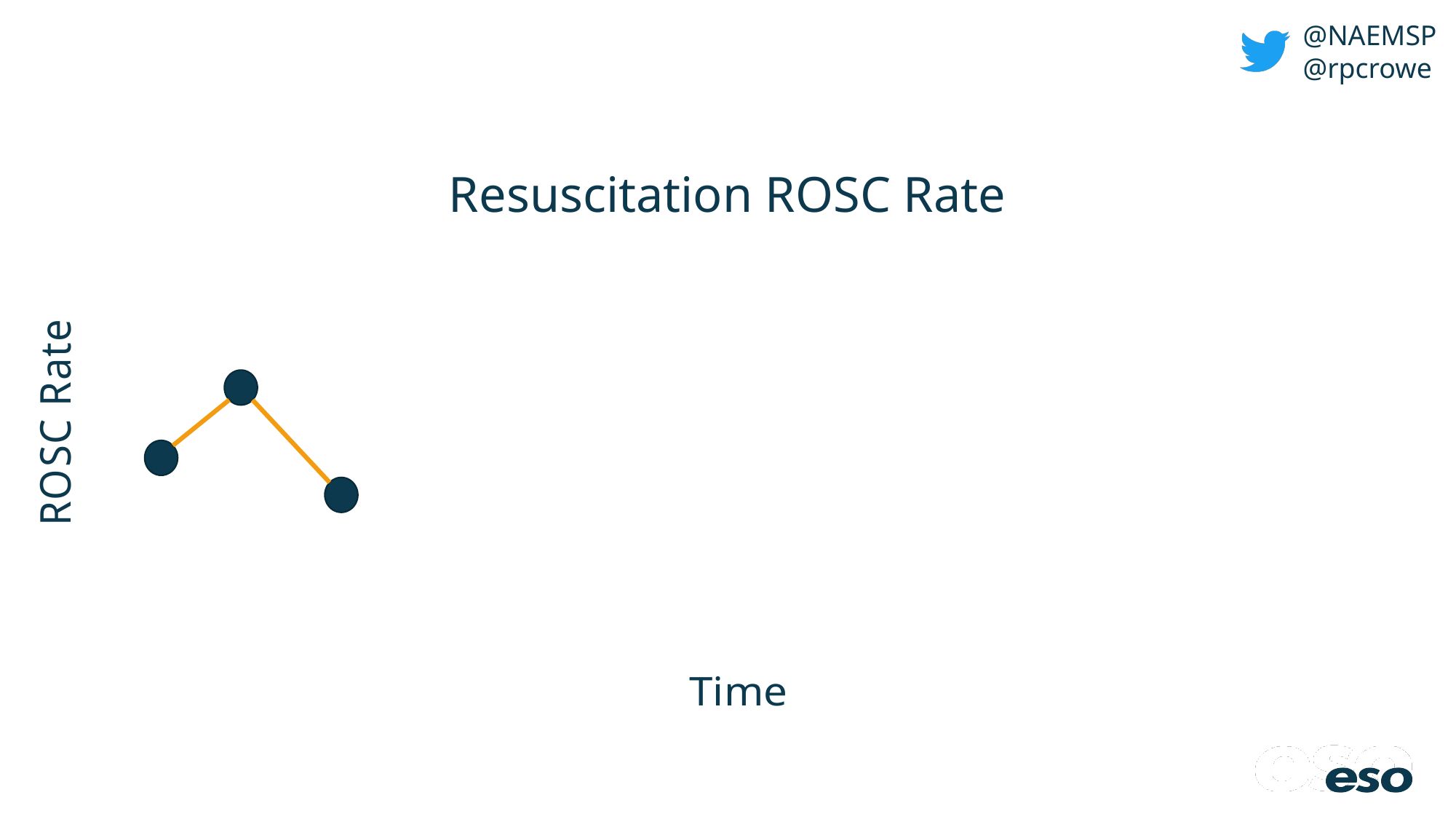
Does the ROSC Rate rise or fall between the first and second points? rise Is the first point or the third point higher on the ROSC Rate axis? the first point Which of the three plotted points is the lowest? the third (last) point What is the label on the vertical axis of the chart? ROSC Rate How many data points are plotted on the line chart? 3 What kind of chart is shown on the slide? line chart What is the title of the chart? Resuscitation ROSC Rate Which of the three plotted points is the highest? the second (middle) point Does the ROSC Rate rise or fall between the second and third points? fall Is the second point or the first point higher on the ROSC Rate axis? the second point